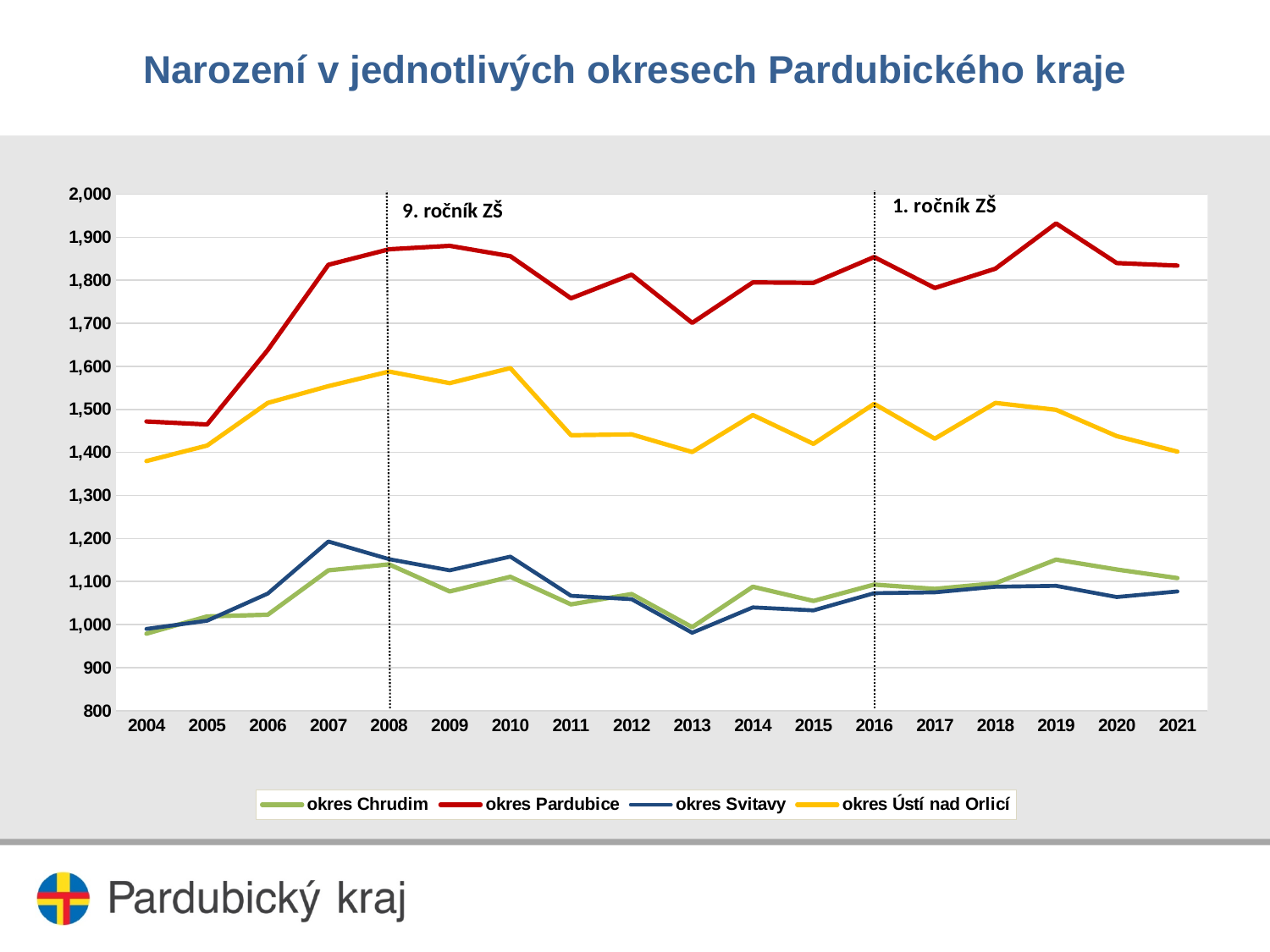
Which district has the highest number of births in 2019? okres Pardubice In 2007, which is larger: okres Svitavy or okres Chrudim? okres Svitavy Is the value for okres Svitavy in 2013 greater or less than 1,100? less Is the value for okres Ústí nad Orlicí in 2010 greater or less than 1,500? greater Does the okres Pardubice line rise or fall between 2004 and 2007? rise At which year is the dotted vertical line labelled "1. ročník ZŠ" placed? 2016 How many years are plotted along the x axis? 18 What kind of chart is shown on the slide? line chart Is the value for okres Pardubice in 2019 greater or less than 1,900? greater How many series does the legend list? 4 Which district has the lowest value in 2007? okres Chrudim In which year does the okres Pardubice line reach its highest value? 2019